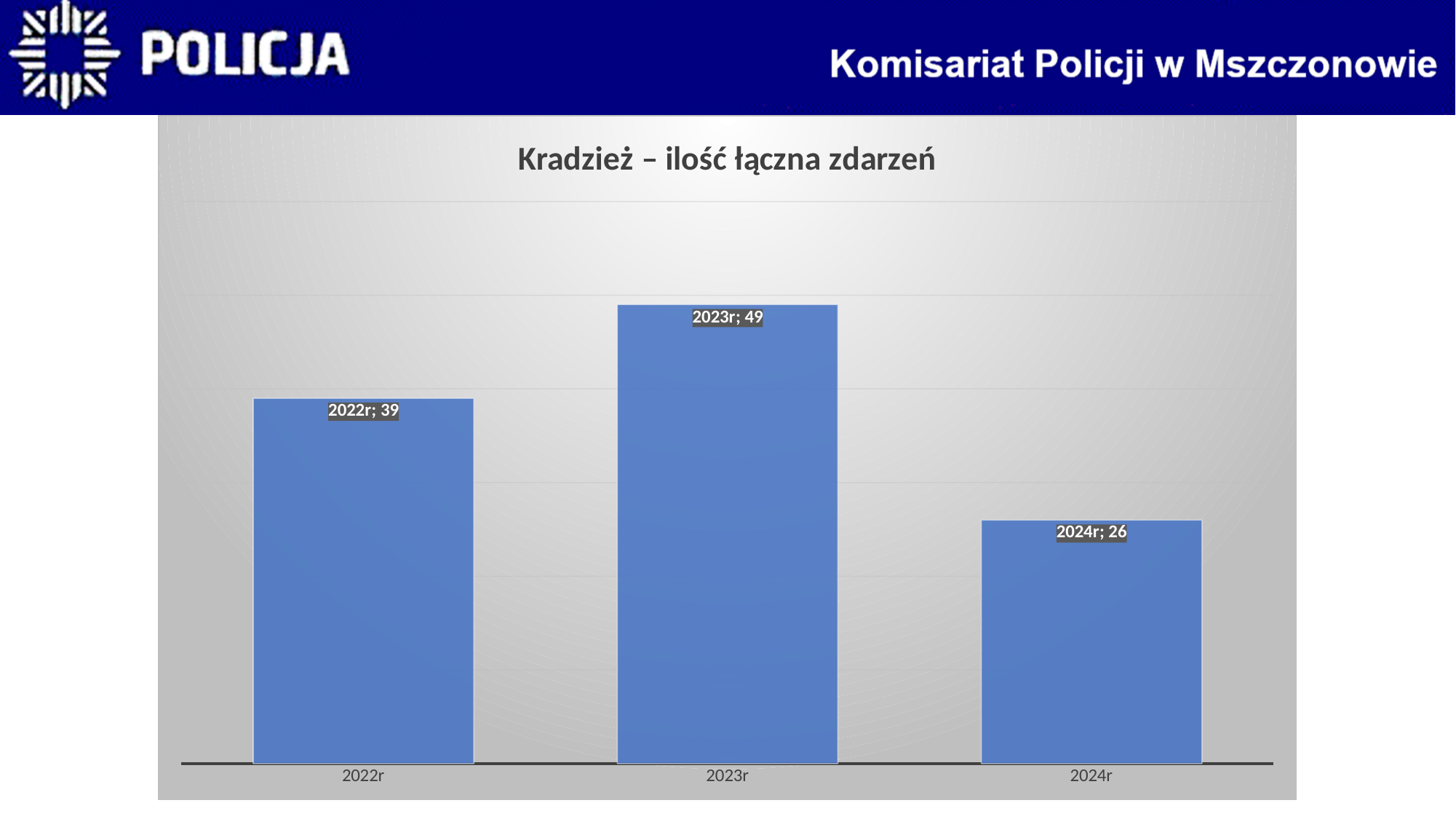
Which year has the highest value? 2023r Does the value rise or fall from 2023r to 2024r? fall What is the title of the chart? Kradzież – ilość łączna zdarzeń What is the value for 2023r? 49 What is the value for 2024r? 26 Which year has the lowest value? 2024r How many categories are shown on the x axis? 3 What kind of chart is shown on the slide? bar chart What is the value for 2022r? 39 What is the difference between the values for 2022r and 2024r? 13 Which is larger, the value for 2022r or the value for 2024r? 2022r What is the difference between the values for 2023r and 2022r? 10